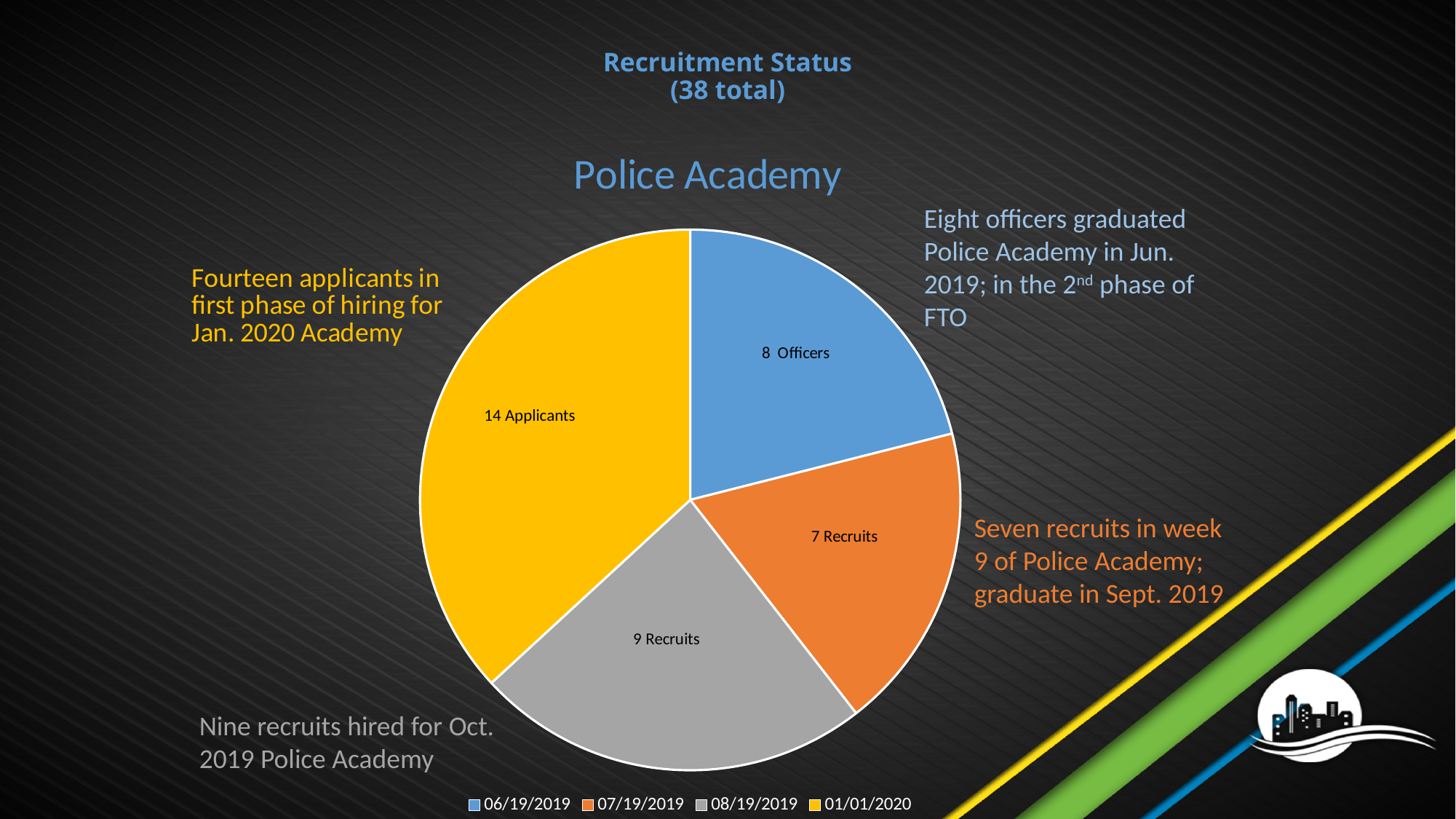
What is the value of the slice labelled Officers? 8 Officers What is the value of the orange slice (07/19/2019)? 7 Recruits How many entries does the legend list? 4 What is the difference between the Applicants slice and the Officers slice? 6 What is the value of the slice labelled Applicants? 14 Applicants What is the title of the chart? Police Academy Which slice is the largest? 14 Applicants (01/01/2020) Which slice is the smallest? 7 Recruits (07/19/2019) What type of chart is shown on the slide? Pie chart What is the value of the gray slice (08/19/2019)? 9 Recruits How many slices does the pie chart have? 4 Which is larger, the 08/19/2019 slice or the 07/19/2019 slice? 08/19/2019 (9 Recruits)